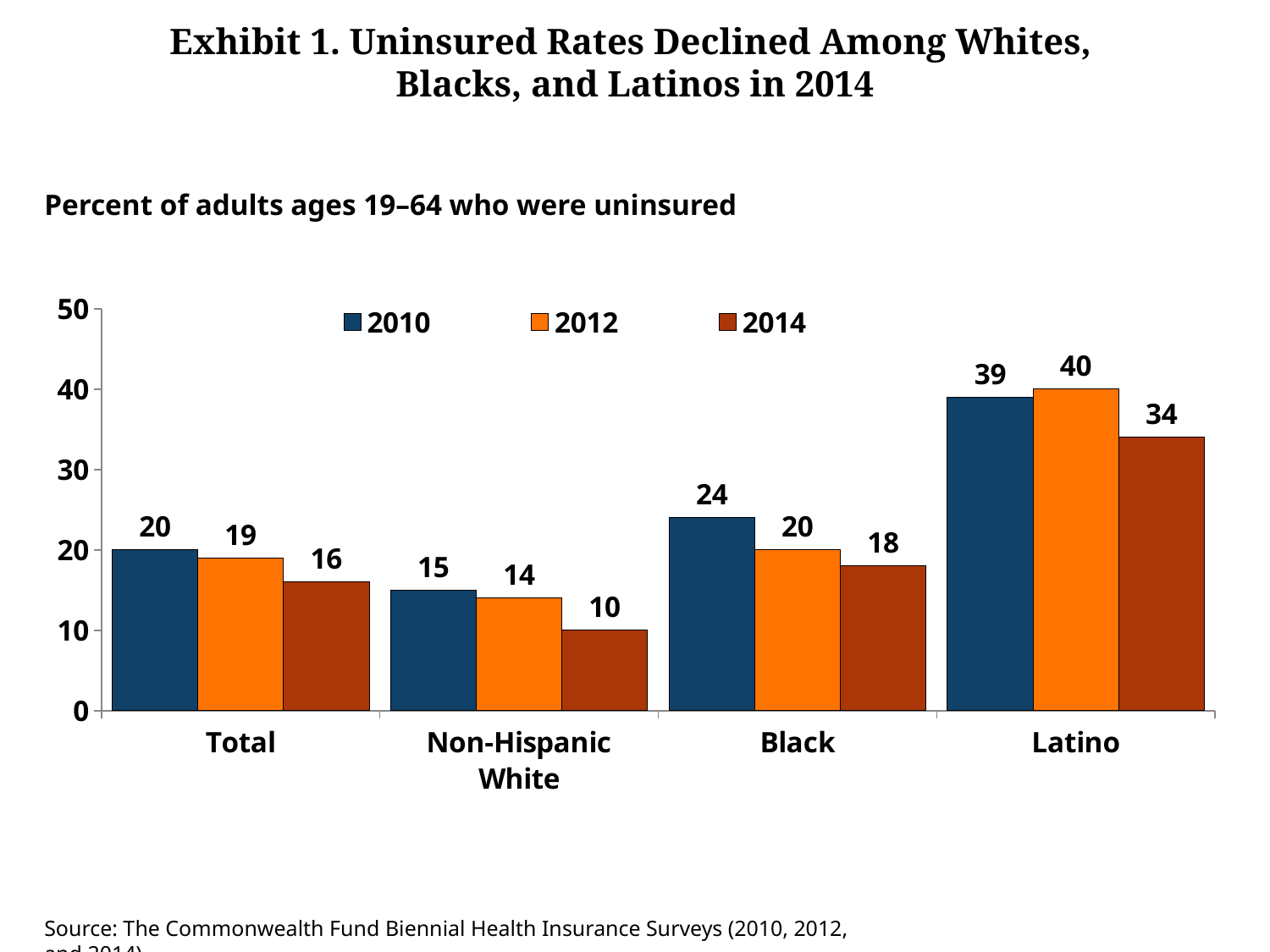
What was the uninsured rate for Black adults in 2012? 20 Which group had the lowest uninsured rate in 2012? Non-Hispanic White What was the uninsured rate for Non-Hispanic White adults in 2010? 15 Which group had the highest uninsured rate in 2014? Latino What kind of chart is shown on the slide? Bar chart By how many percentage points did the uninsured rate for Black adults fall from 2010 to 2014? 6 What is the difference between the 2014 uninsured rates for Latino and Non-Hispanic White adults? 24 Which years are listed in the legend? 2010, 2012, 2014 Which was larger, the 2010 uninsured rate for Black adults or the 2010 Total rate? Black How many groups are shown on the x axis? 4 How many series does the legend list? 3 What was the uninsured rate for Latino adults in 2014? 34